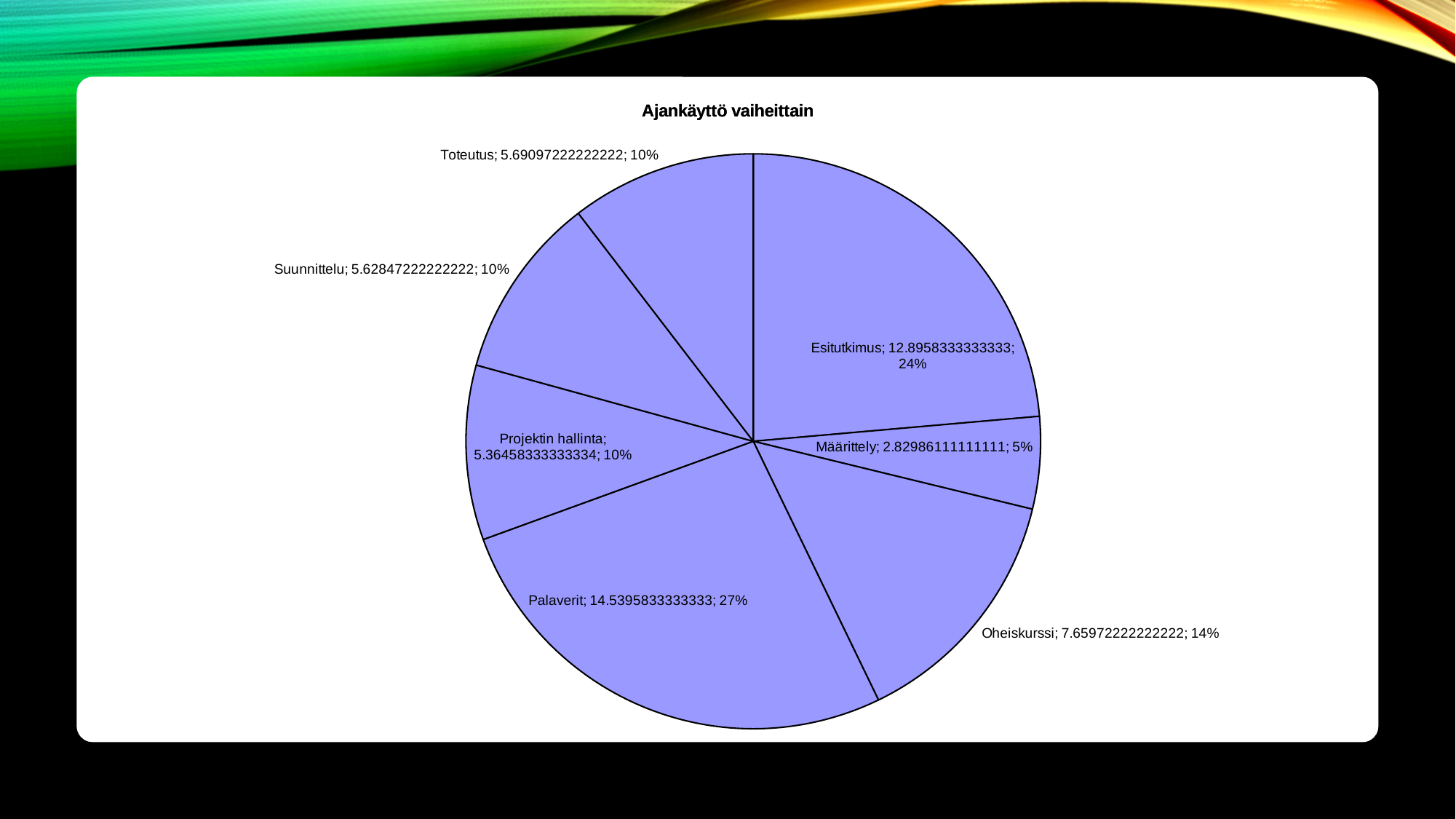
What is the value for Esitutkimus? 12.8958333333333 Which category has the largest slice? Palaverit What kind of chart is shown on the slide? pie chart What is the title of the chart? Ajankäyttö vaiheittain Which is larger, Oheiskurssi or Toteutus? Oheiskurssi What is the difference in percentage share between Palaverit and Esitutkimus? 3% What share of the pie does Oheiskurssi represent? 14% Which category has the smallest slice? Määrittely What is the value for Määrittely? 2.82986111111111 How many slices does the pie chart have? 7 What is the value for Palaverit? 14.5395833333333 What share of the pie does Esitutkimus represent? 24%